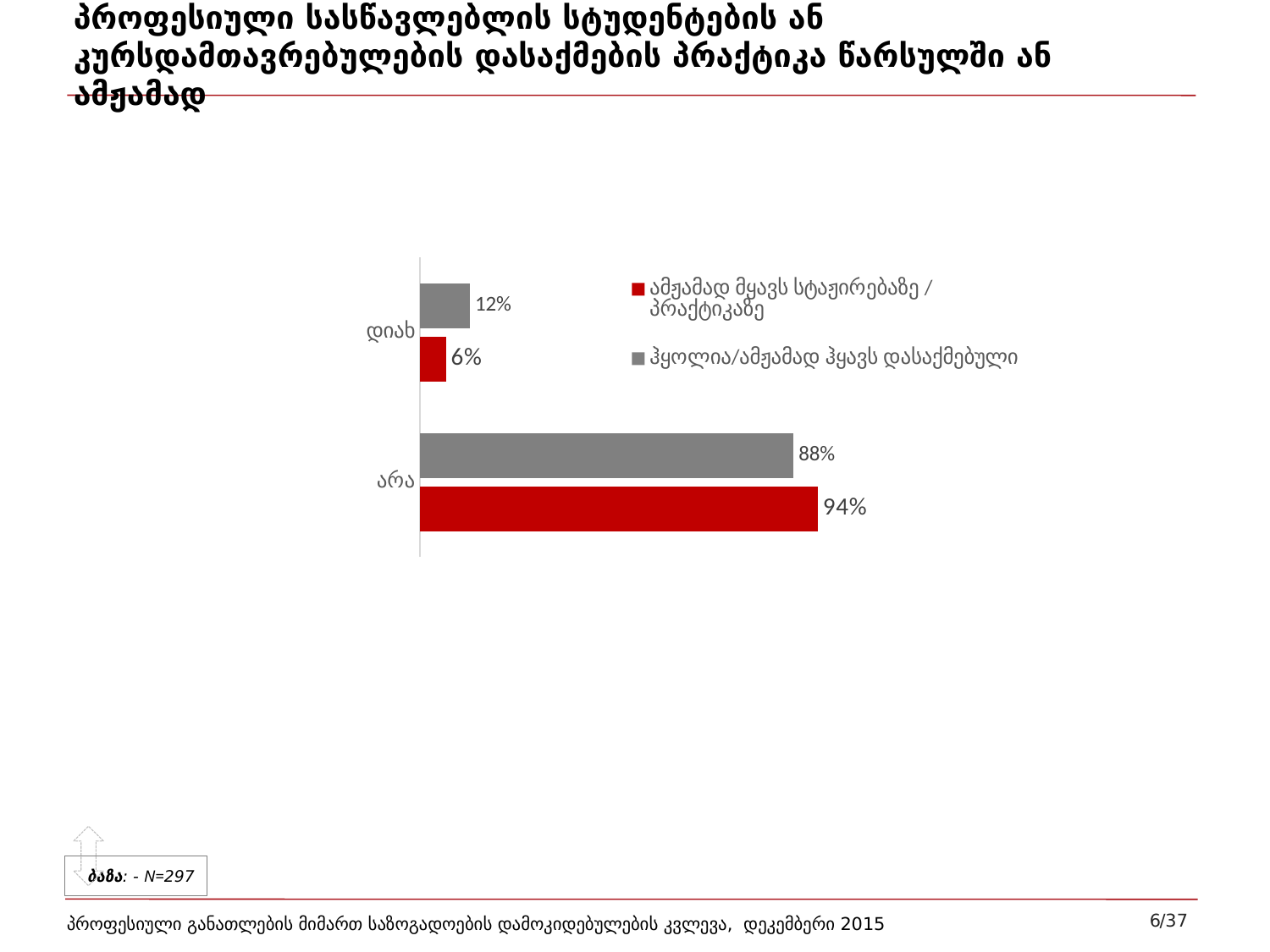
What is the value for "დიახ" in the series "ჰყოლია/ამჟამად ჰყავს დასაქმებული"? 12% What colour are the bars for the series "ამჟამად მყავს სტაჟირებაზე / პრაქტიკაზე"? red What kind of chart is shown on the slide? bar chart Which category has the highest value in the series "ამჟამად მყავს სტაჟირებაზე / პრაქტიკაზე"? არა What is the difference between the two series' values for "არა"? 6% What is the value for "დიახ" in the series "ამჟამად მყავს სტაჟირებაზე / პრაქტიკაზე"? 6% For "დიახ", which series has the larger value? ჰყოლია/ამჟამად ჰყავს დასაქმებული What is the value for "არა" in the series "ამჟამად მყავს სტაჟირებაზე / პრაქტიკაზე"? 94% How many series does the legend list? 2 Which category has the lowest value in the series "ჰყოლია/ამჟამად ჰყავს დასაქმებული"? დიახ How many categories are shown on the chart? 2 What is the value for "არა" in the series "ჰყოლია/ამჟამად ჰყავს დასაქმებული"? 88%